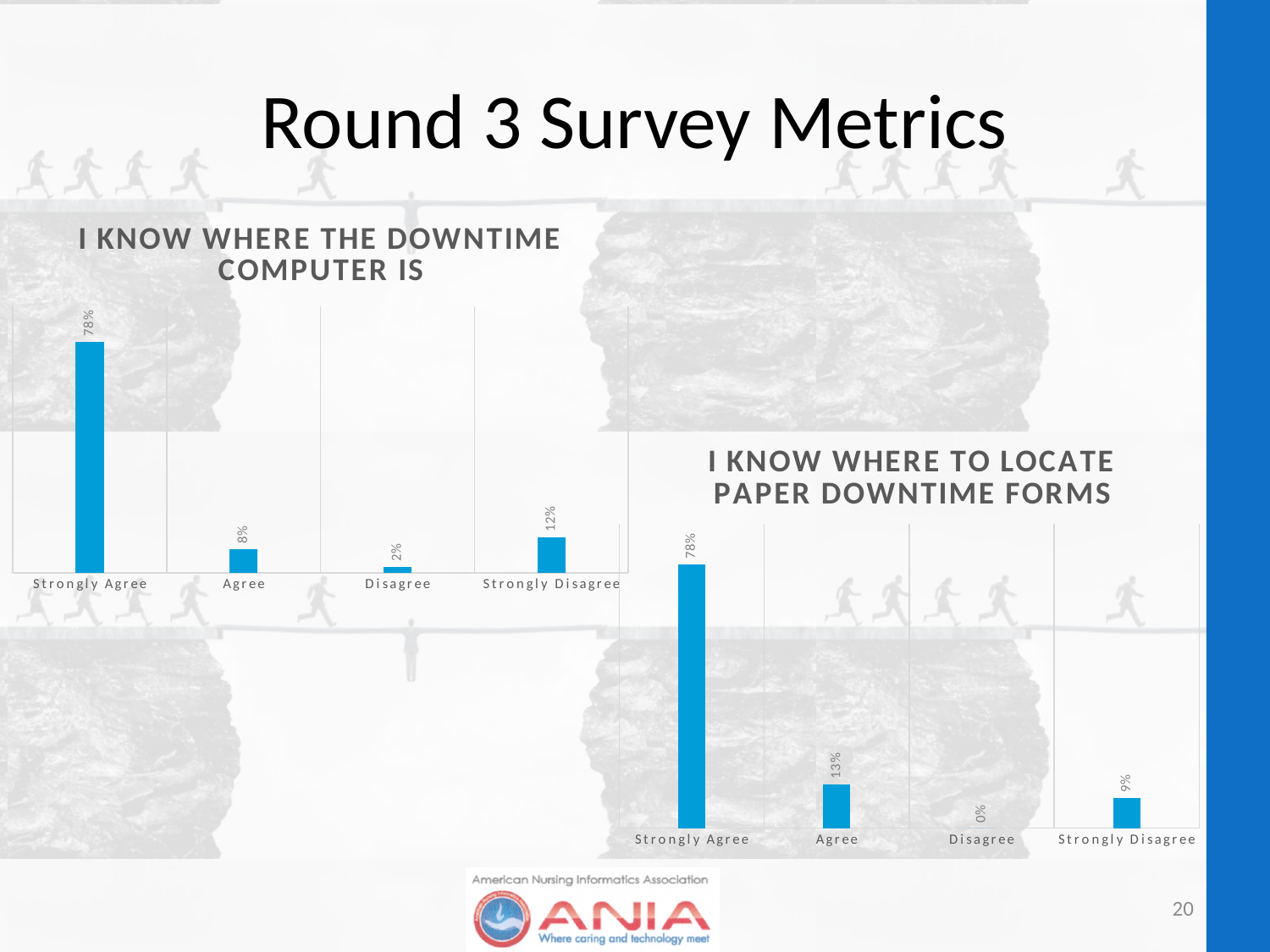
In the chart titled "I Know Where the Downtime Computer Is", what is the difference between Strongly Disagree and Agree? 4% What kind of chart is the chart titled "I Know Where to Locate Paper Downtime Forms"? Bar chart In the chart titled "I Know Where the Downtime Computer Is", which category has the lowest value? Disagree In the chart titled "I Know Where to Locate Paper Downtime Forms", what is the value for Disagree? 0% In the chart titled "I Know Where the Downtime Computer Is", what is the value for Disagree? 2% In the chart titled "I Know Where to Locate Paper Downtime Forms", what is the value for Strongly Disagree? 9% How many categories are shown in the chart titled "I Know Where the Downtime Computer Is"? 4 In the chart titled "I Know Where the Downtime Computer Is", which is larger, Agree or Strongly Disagree? Strongly Disagree In the chart titled "I Know Where to Locate Paper Downtime Forms", which category has the highest value? Strongly Agree In the chart titled "I Know Where the Downtime Computer Is", what is the value for Strongly Agree? 78% In the chart titled "I Know Where to Locate Paper Downtime Forms", what is the value for Agree? 13% In the chart titled "I Know Where to Locate Paper Downtime Forms", what is the difference between Strongly Agree and Agree? 65%